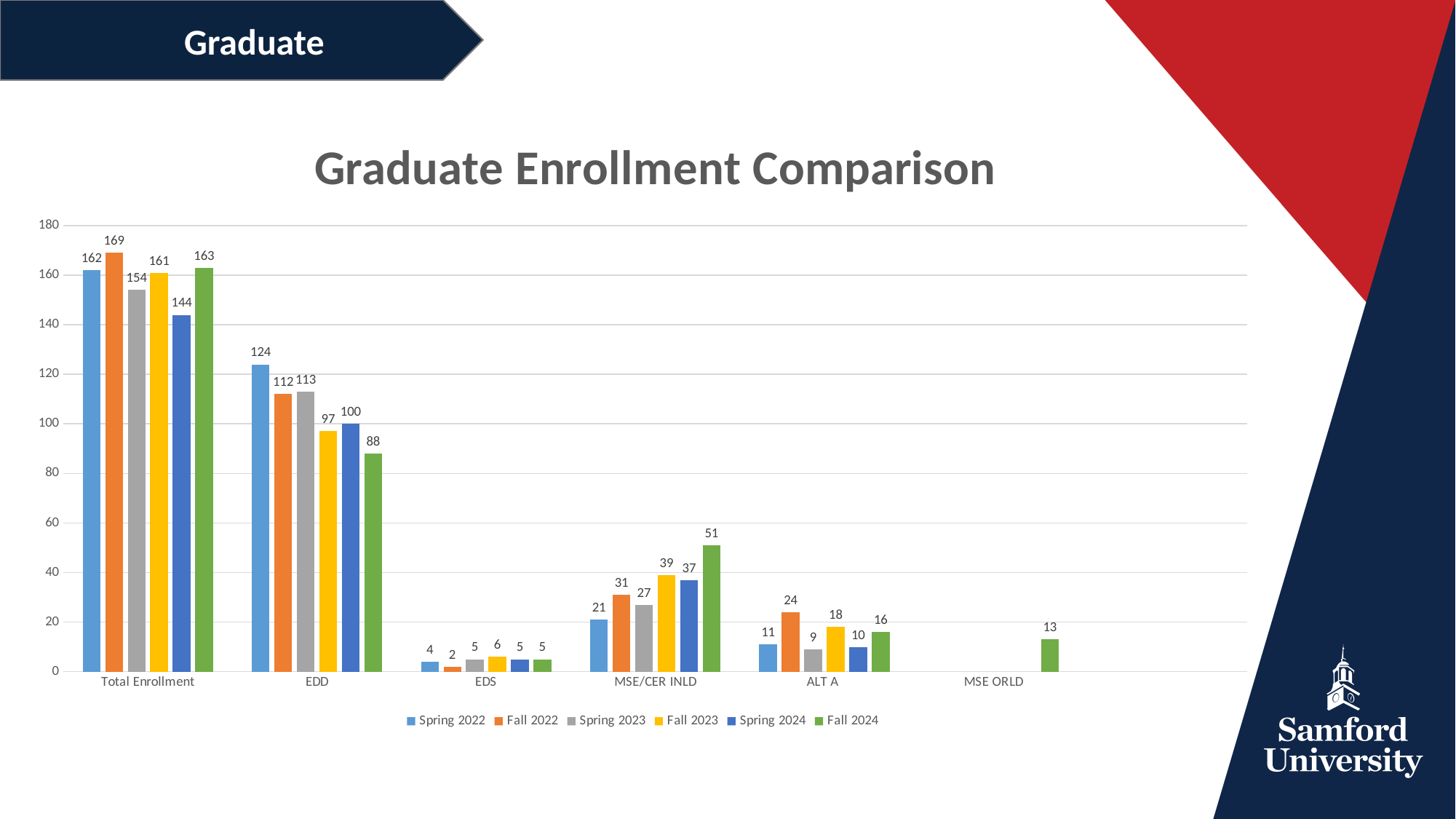
What is the Fall 2024 value for MSE ORLD? 13 What kind of chart is shown on the slide? Bar chart What is the Spring 2024 value for Total Enrollment? 144 What is the difference between the Spring 2022 and Fall 2024 values for EDD? 36 What is the Fall 2022 value for Total Enrollment? 169 Which series has the highest value for MSE/CER INLD? Fall 2024 How many categories are shown on the x axis? 6 How many series does the legend list? 6 What is the Fall 2024 value for EDD? 88 What is the title of the chart? Graduate Enrollment Comparison Which series has the lowest value for EDS? Fall 2022 Which is larger for ALT A: the Fall 2022 value or the Fall 2023 value? Fall 2022